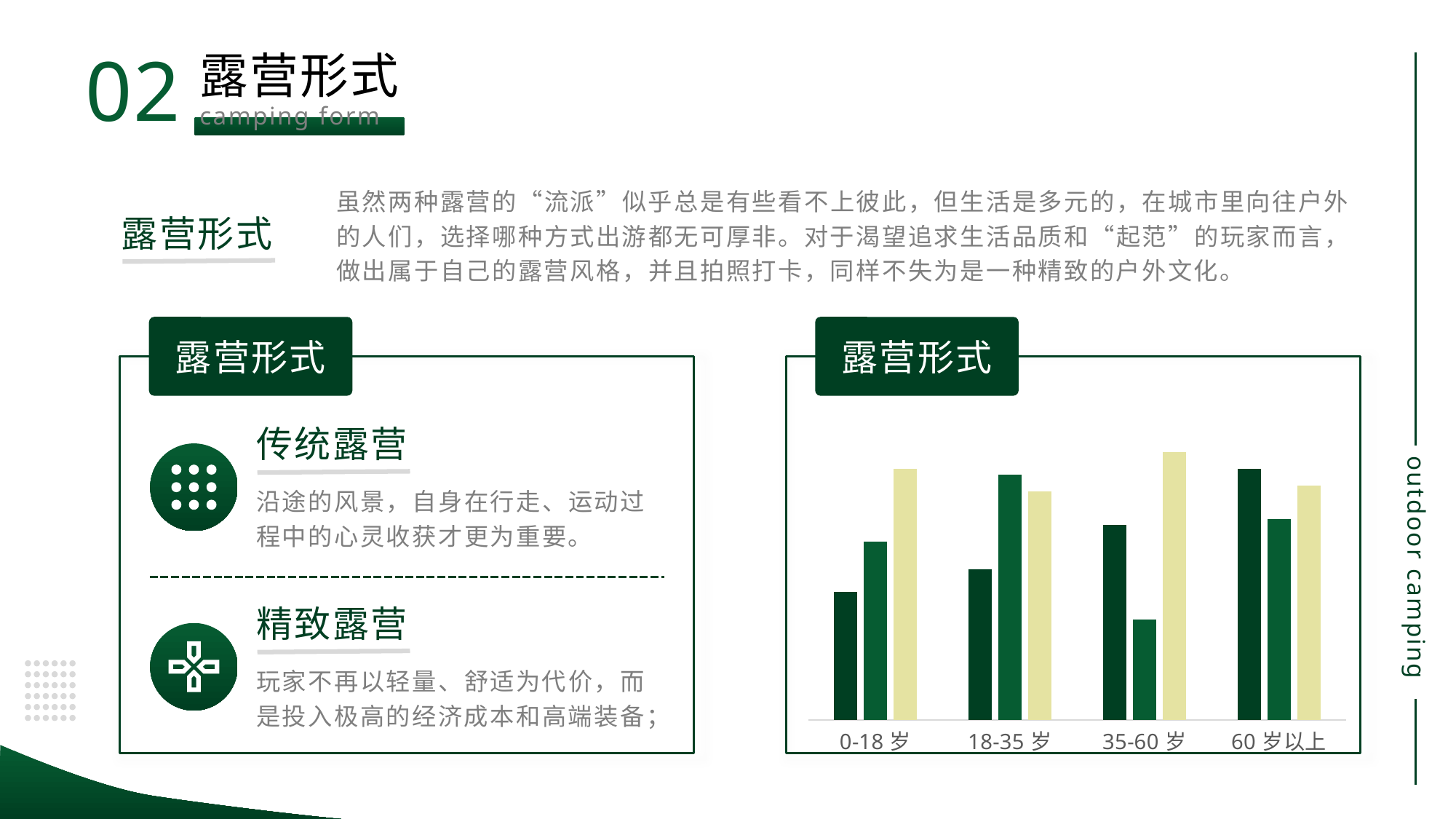
Which age group contains the shortest bar in the chart? 35-60 岁 What kind of chart is shown on the right side of the slide? bar chart In the 0-18 岁 group, which coloured bar is the tallest? the light yellow bar What is the label of the last (rightmost) category on the x axis of the bar chart? 60 岁以上 In the 35-60 岁 group, which coloured bar is the shortest? the medium green bar In the 60 岁以上 group, is the dark green bar or the medium green bar taller? the dark green bar Is the dark green bar taller for 0-18 岁 or for 60 岁以上? 60 岁以上 Do the dark green bars rise or fall from left to right across the age groups? rise How many age-group categories are shown on the x axis of the bar chart? 4 What is the title shown in the box above the bar chart? 露营形式 Which age group contains the tallest bar in the chart? 35-60 岁 How many bars are plotted for each age group in the bar chart? 3